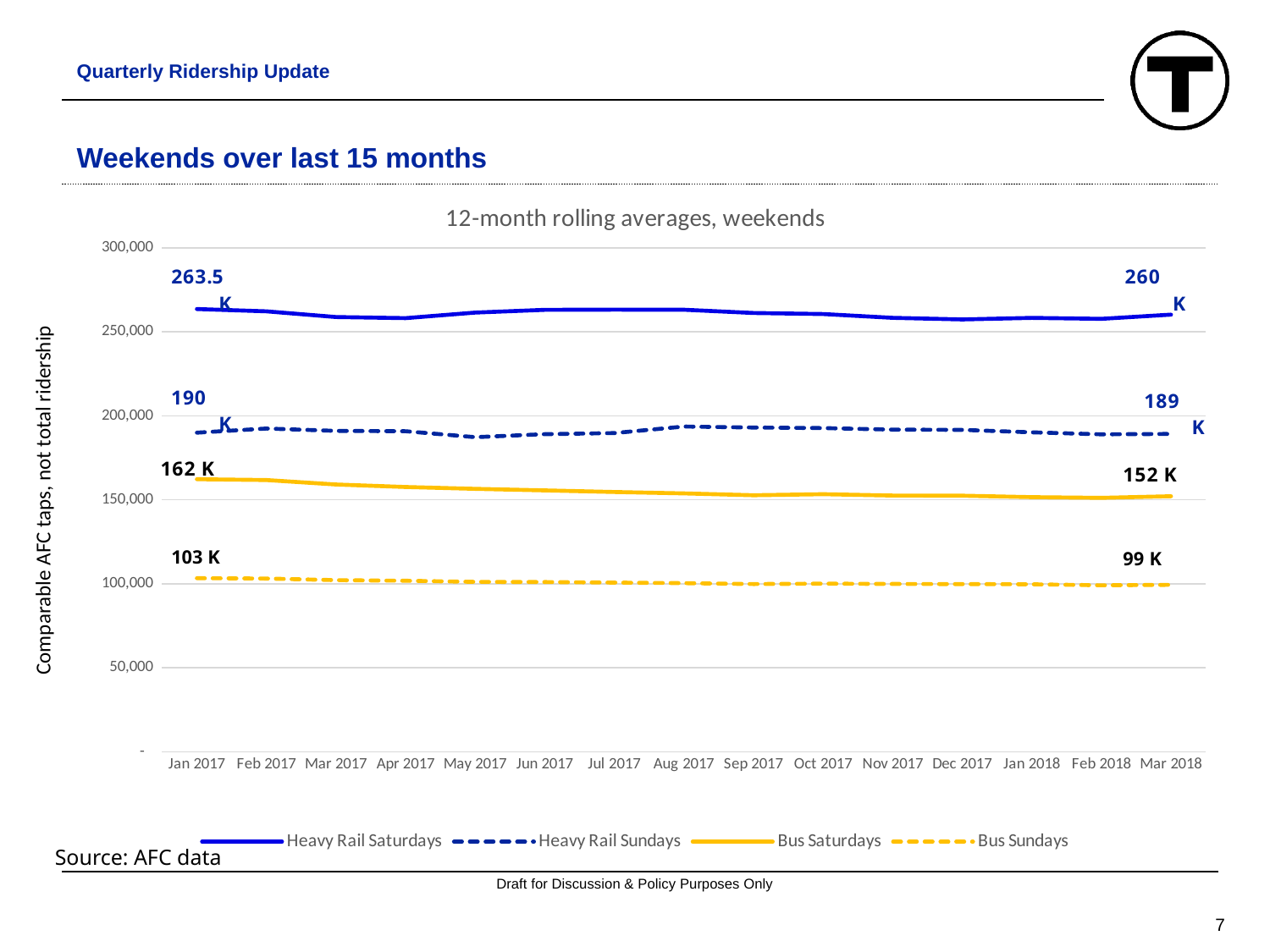
What is the value for Heavy Rail Saturdays in Jan 2017? 263.5 K How many series does the legend list? 4 How many months are shown along the x axis? 15 What is the value for Heavy Rail Saturdays in Mar 2018? 260 K Is the value for Bus Saturdays in Jul 2017 greater or less than 200,000? less What is the title of the chart? 12-month rolling averages, weekends What kind of chart is shown on the slide? line chart By how much did Bus Saturdays fall from Jan 2017 (162 K) to Mar 2018 (152 K)? 10 K What is the value for Bus Sundays in Mar 2018? 99 K What is the value for Bus Saturdays in Jan 2017? 162 K Which series has the lowest values across the chart? Bus Sundays Which is larger in Mar 2018: Heavy Rail Sundays or Bus Saturdays? Heavy Rail Sundays